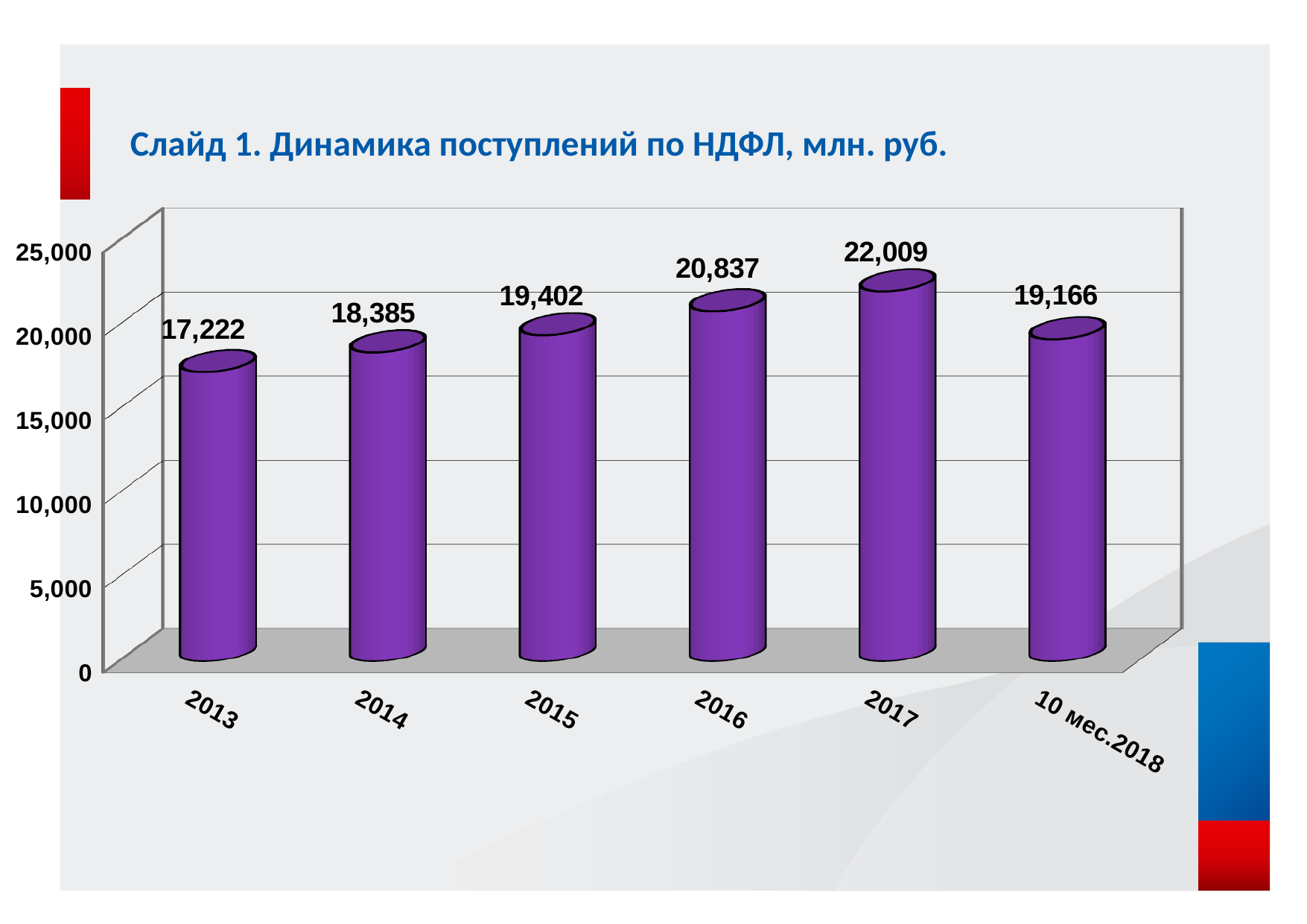
Which is larger, the value for 2015 or the value for 10 мес.2018? 2015 What is the value for 10 мес.2018? 19,166 Do the values rise or fall from 2013 to 2017? rise What is the difference between the values for 2017 and 2016? 1,172 What kind of chart is shown on the slide? bar chart Is the value for 2016 greater or less than 20,000? greater Which category has the lowest value? 2013 What is the value for 2013? 17,222 What is the difference between the values for 2014 and 2013? 1,163 What is the value for 2017? 22,009 Which category has the highest value? 2017 How many categories are shown on the x axis? 6